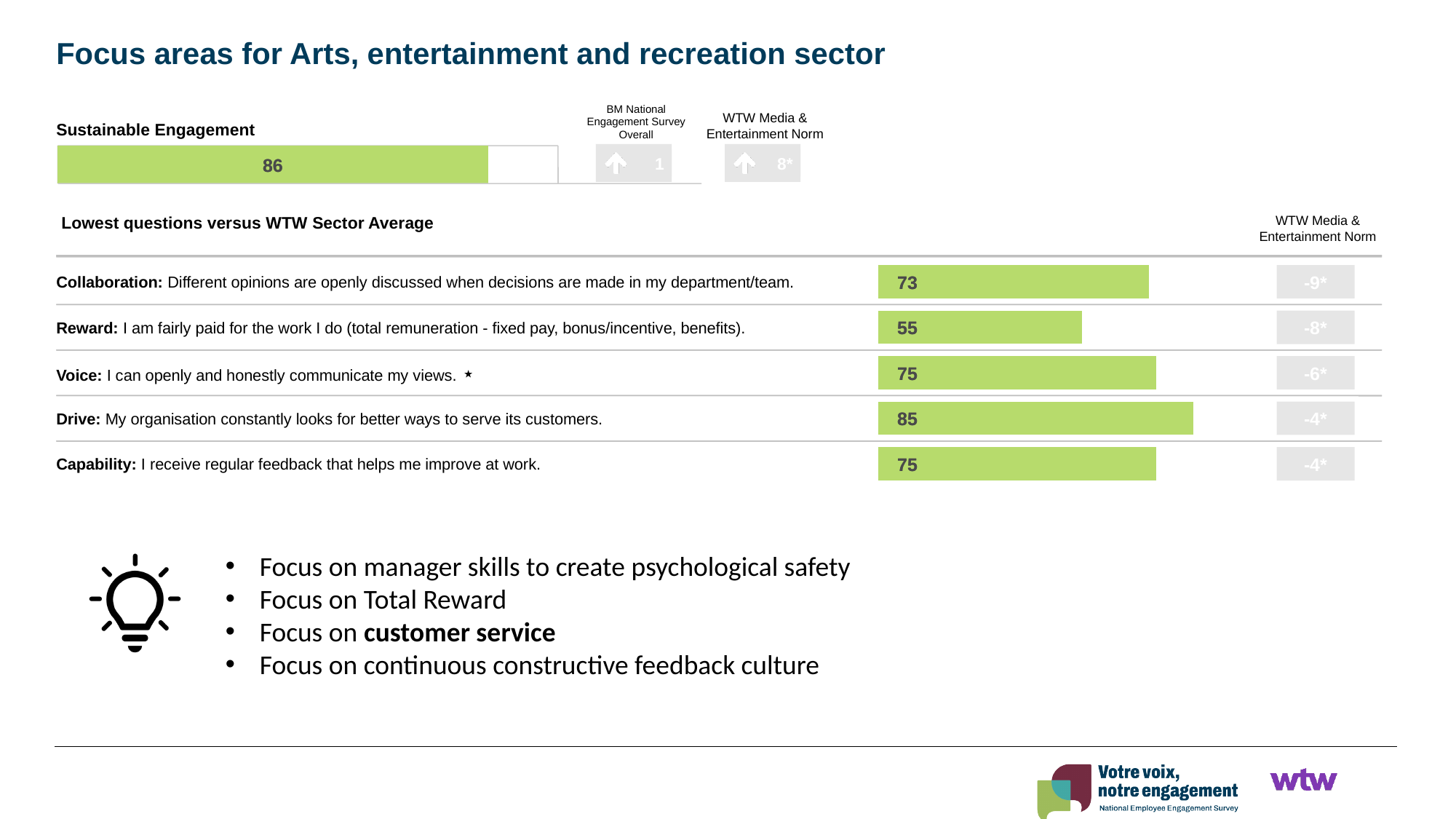
In the Sustainable Engagement chart, what is the difference versus the BM National Engagement Survey Overall? 1 In the Lowest questions versus WTW Sector Average chart, what is the score for Collaboration? 73 In the Lowest questions versus WTW Sector Average chart, what is the difference between the Drive score and the Reward score? 30 In the Lowest questions versus WTW Sector Average chart, what is the WTW Media & Entertainment Norm difference for Collaboration? -9* In the Lowest questions versus WTW Sector Average chart, how many questions are shown? 5 In the Sustainable Engagement chart, what is the difference versus the WTW Media & Entertainment Norm? 8* In the Lowest questions versus WTW Sector Average chart, which has a higher score, Collaboration or Voice? Voice In the Lowest questions versus WTW Sector Average chart, what is the score for Reward? 55 In the Lowest questions versus WTW Sector Average chart, which question has the lowest score? Reward What kind of chart is used for the Lowest questions versus WTW Sector Average? Bar chart In the Sustainable Engagement chart, what is the Sustainable Engagement score? 86 In the Lowest questions versus WTW Sector Average chart, which question has the highest score? Drive